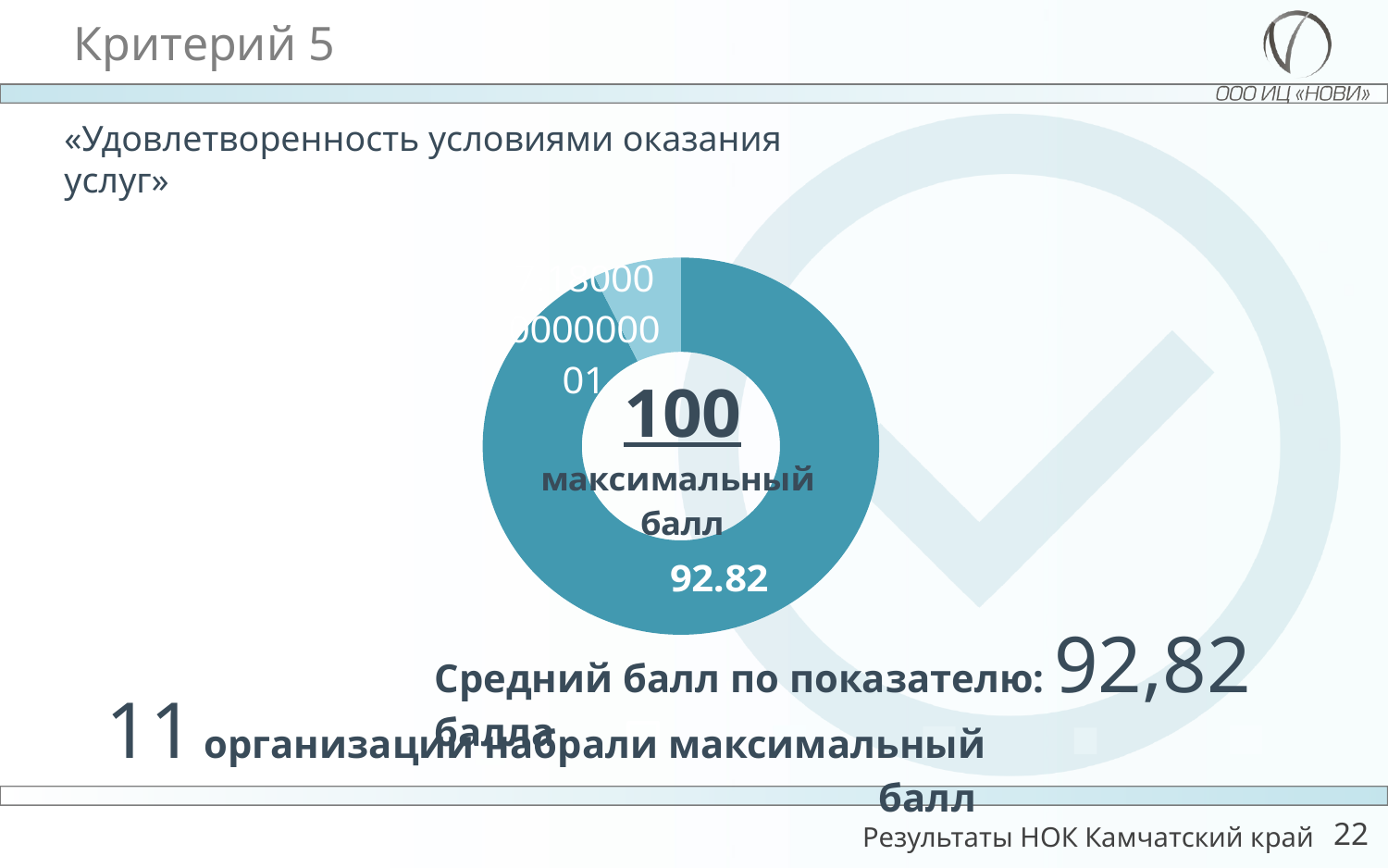
Is the value of the large slice of the doughnut chart greater or less than 50? greater How many organisations scored the maximum score according to the slide? 11 What value is printed on the large dark-blue slice of the doughnut chart? 92.82 How many slices does the doughnut chart have? 2 What number is printed in the centre of the doughnut chart? 100 What text accompanies the number 100 in the centre of the doughnut chart? максимальный балл Which slice of the doughnut chart is larger, the dark-blue one labelled 92.82 or the small light-blue one? The dark-blue one labelled 92.82 What is the average score for the indicator stated below the chart? 92,82 What kind of chart is shown on the slide? Doughnut (pie) chart